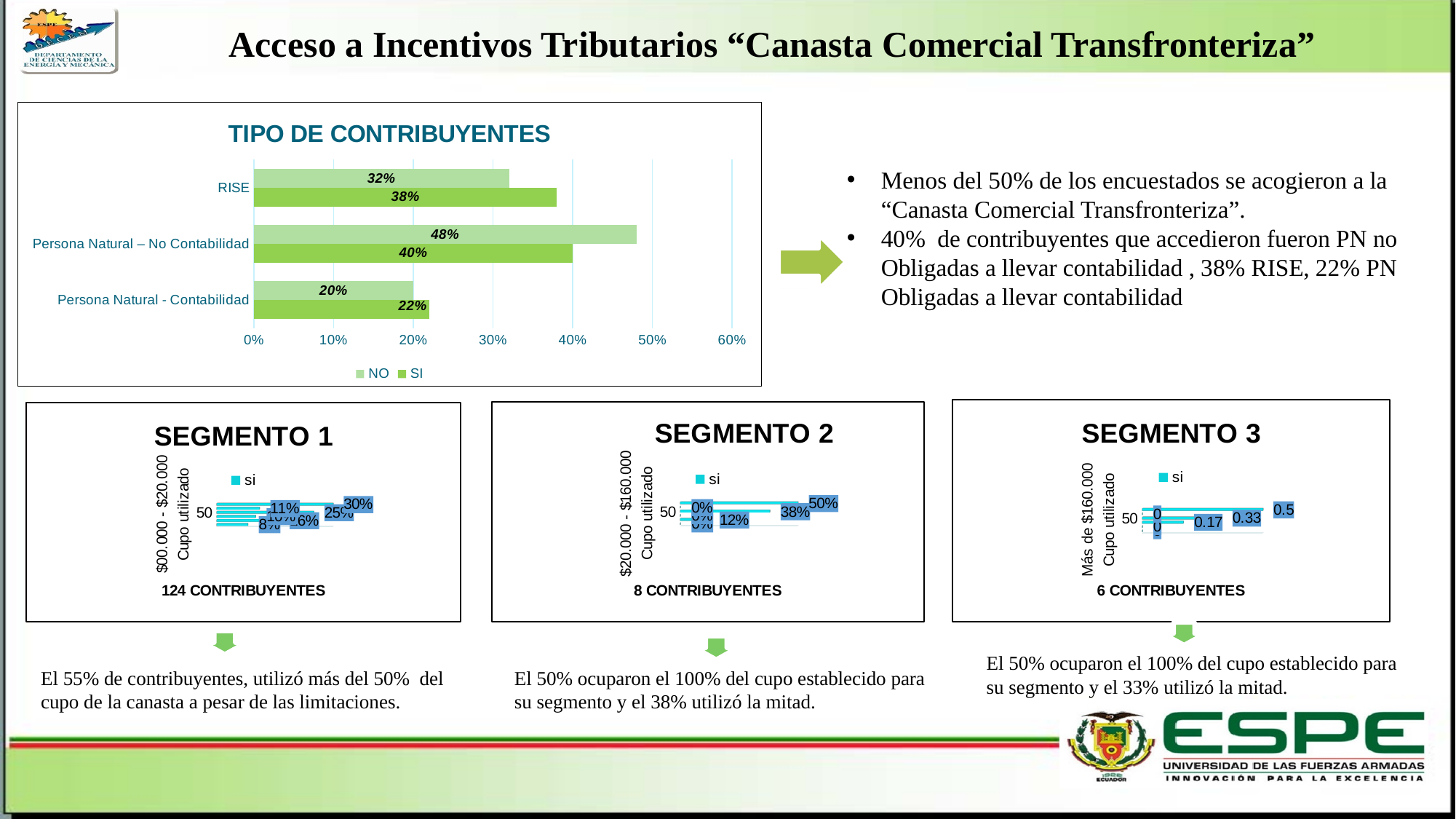
In the 'TIPO DE CONTRIBUYENTES' chart, which category has the highest SI value? Persona Natural – No Contabilidad How many categories are shown in the 'TIPO DE CONTRIBUYENTES' chart? 3 In the 'TIPO DE CONTRIBUYENTES' chart, which is larger for RISE, the NO value or the SI value? SI In the 'TIPO DE CONTRIBUYENTES' chart, what is the difference between the NO and SI values for Persona Natural – No Contabilidad? 8% How many series does the legend of the 'TIPO DE CONTRIBUYENTES' chart list? 2 In the 'TIPO DE CONTRIBUYENTES' chart, what is the NO value for Persona Natural – No Contabilidad? 48% In the 'TIPO DE CONTRIBUYENTES' chart, is the NO value for Persona Natural – No Contabilidad greater or less than 40%? greater In the 'TIPO DE CONTRIBUYENTES' chart, what is the SI value for Persona Natural - Contabilidad? 22% What type of chart is 'TIPO DE CONTRIBUYENTES'? Bar chart In the 'TIPO DE CONTRIBUYENTES' chart, what is the SI value for RISE? 38% In the 'TIPO DE CONTRIBUYENTES' chart, which category has the lowest NO value? Persona Natural - Contabilidad In the 'TIPO DE CONTRIBUYENTES' chart, what is the NO value for RISE? 32%